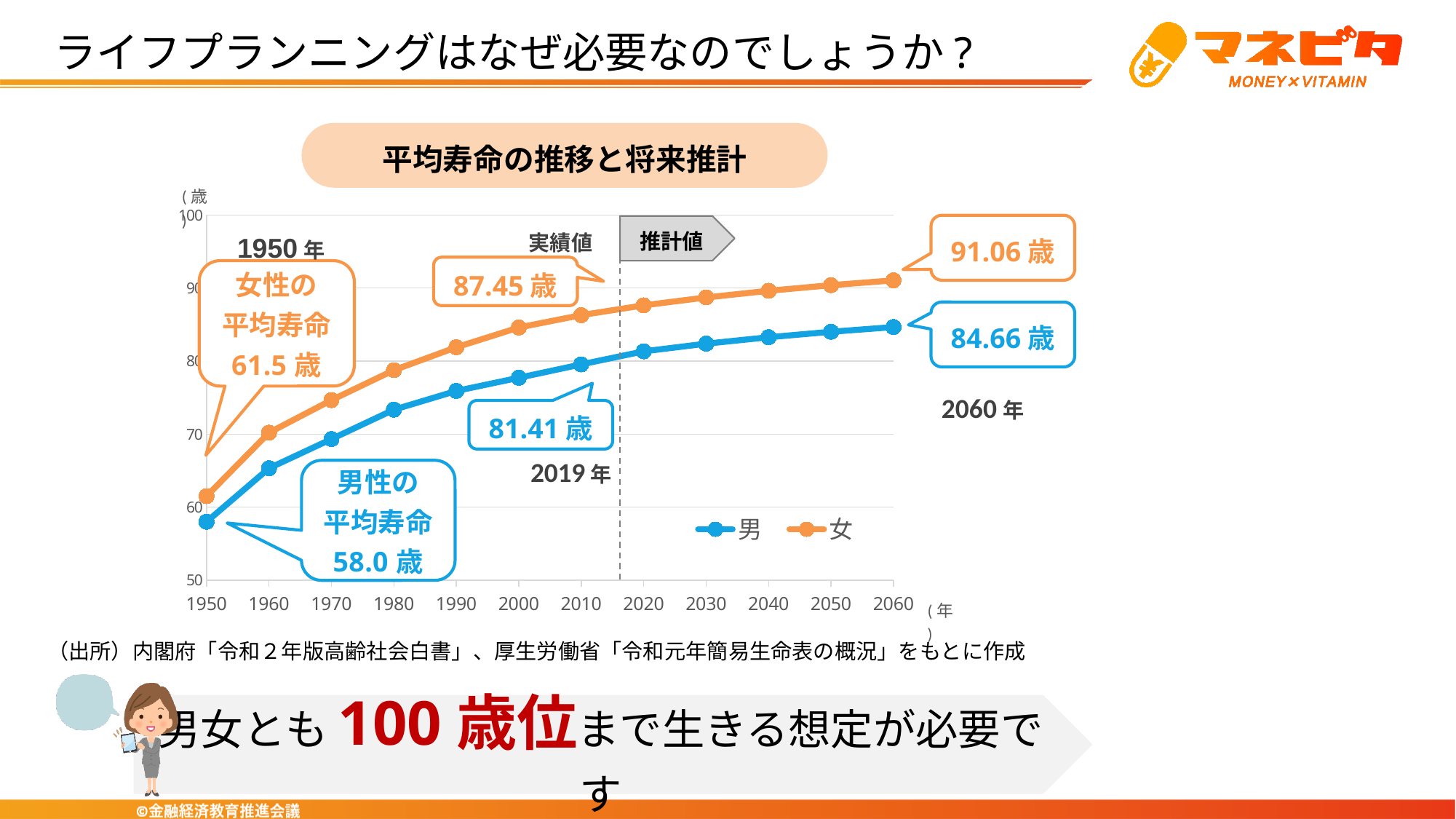
Which series has the higher value in 2019, 男 or 女? 女 What is the projected life expectancy for men (男) in 2060? 84.66歳 How many series does the chart legend list? 2 What is the average life expectancy for women (女性) in 1950 according to the chart? 61.5歳 What kind of chart is shown on the slide? line chart Is the value for 男 in 2000 greater or less than 80? less What is the 2019 life expectancy value shown for men (男)? 81.41歳 What is the projected life expectancy for women (女) in 2060? 91.06歳 What is the average life expectancy for men (男性) in 1950 according to the chart? 58.0歳 What is the title of the chart? 平均寿命の推移と将来推計 What is the difference between the female and male life expectancy values shown for 2060? 6.40歳 What is the difference between the female and male life expectancy values shown for 1950? 3.5歳